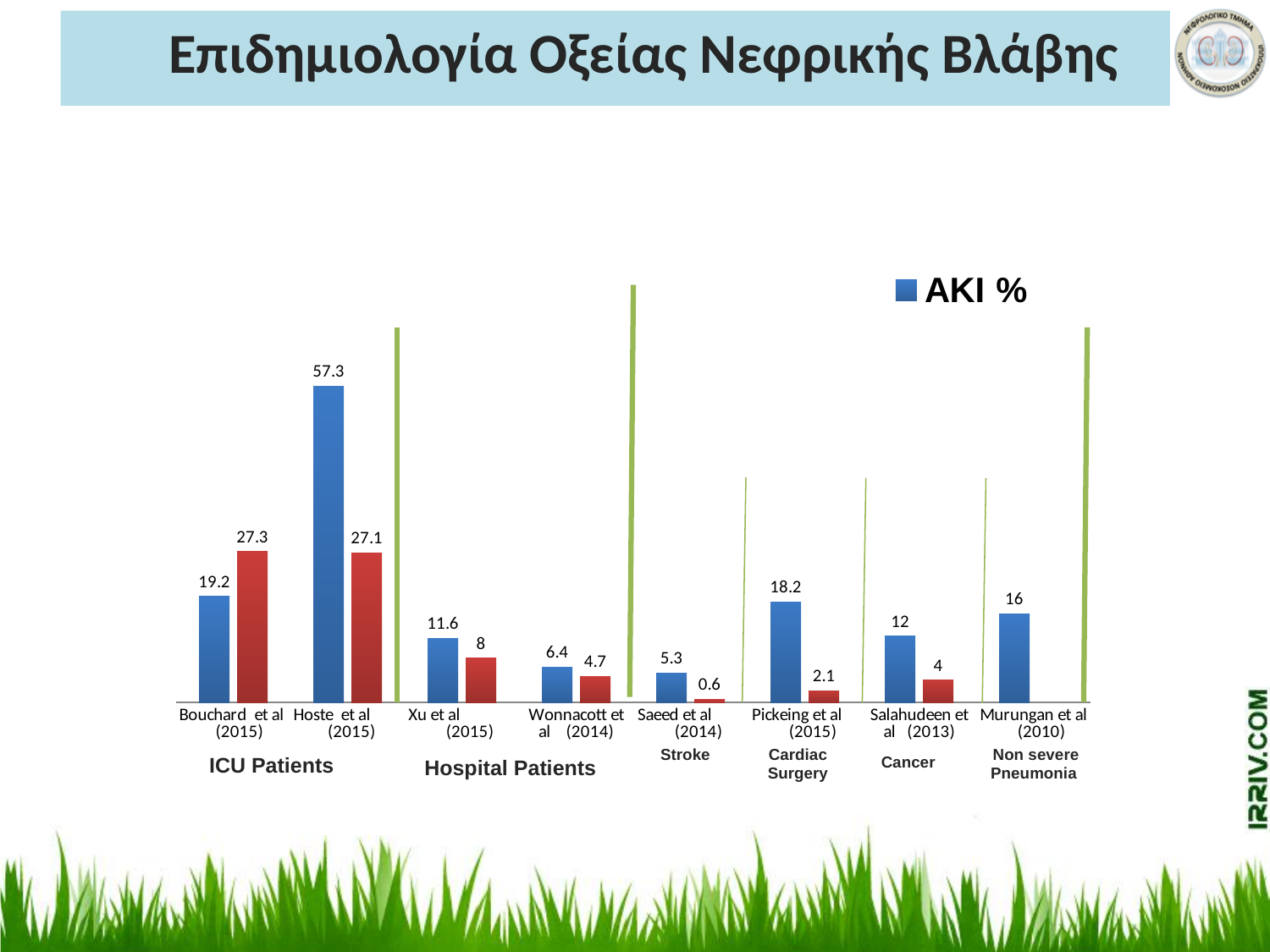
What is the AKI % value for Xu et al (2015)? 11.6 Which study has the highest AKI % value? Hoste et al (2015) What is the difference between the AKI % values for Pickeing et al (2015) and Salahudeen et al (2013)? 6.2 What is the difference between the AKI % values for Hoste et al (2015) and Bouchard et al (2015)? 38.1 What kind of chart is shown on the slide? Bar chart What is the AKI % value for Murungan et al (2010)? 16 How many studies are shown on the x axis of the chart? 8 Which study has the lowest AKI % value? Saeed et al (2014) What is the AKI % value for Hoste et al (2015)? 57.3 What is the value shown on the red bar for Bouchard et al (2015)? 27.3 How many series does the legend list? 1 Which has a higher AKI % value, Pickeing et al (2015) or Salahudeen et al (2013)? Pickeing et al (2015)